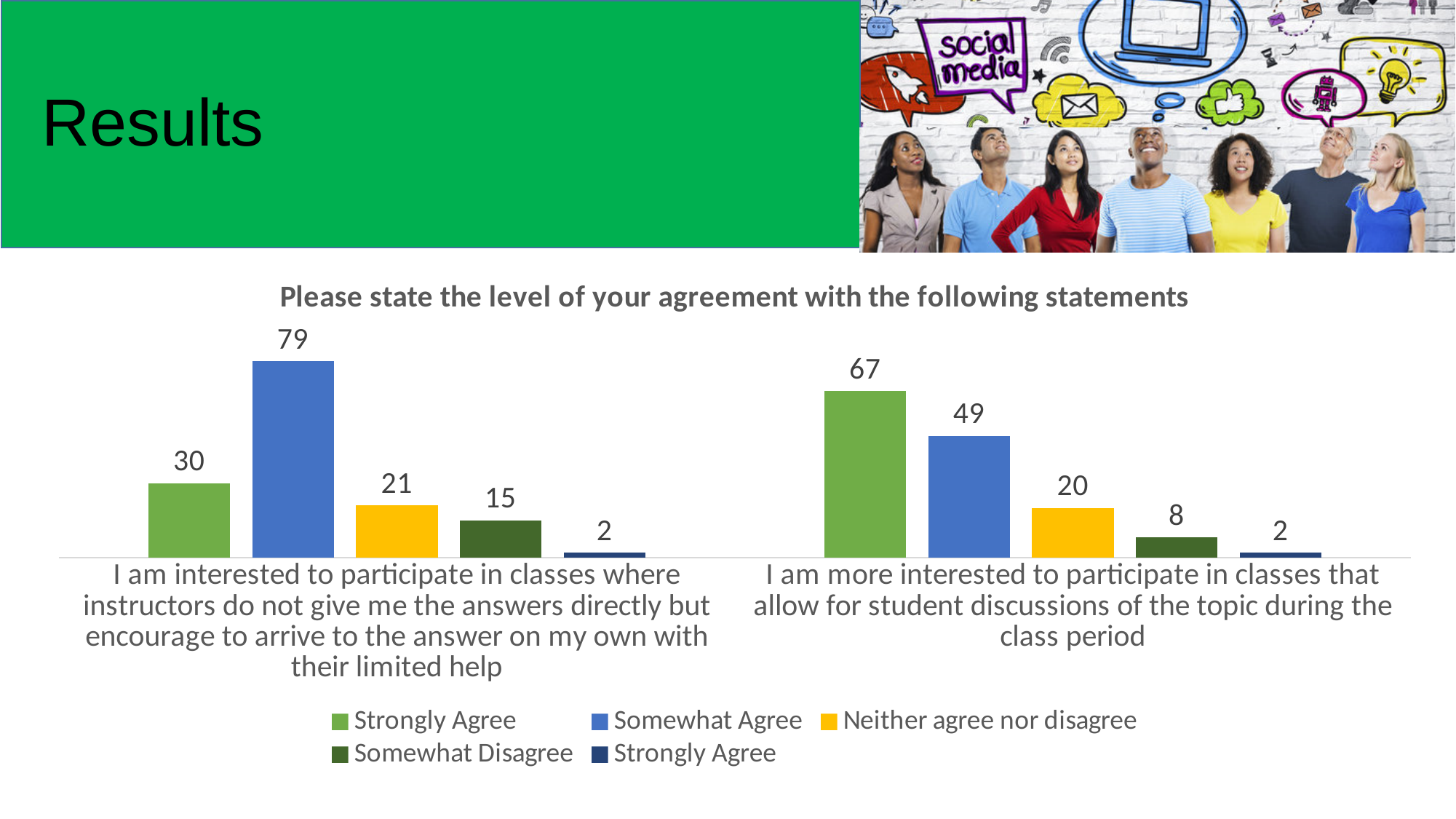
What is the title of the chart? Please state the level of your agreement with the following statements Which response has the highest value for the statement about instructors not giving answers directly? Somewhat Agree How many series does the legend list? 5 Which statement has the larger Somewhat Disagree value? I am interested to participate in classes where instructors do not give me the answers directly... How many statements (categories) are shown on the x axis? 2 What is the difference between the Somewhat Agree values for the two statements? 30 What is the value of the light green (first legend entry) bar for the statement about student discussions during the class period? 67 What is the value for Somewhat Agree for the statement "I am interested to participate in classes where instructors do not give me the answers directly..."? 79 Which response has the lowest value for the statement about student discussions during the class period? Strongly Agree (dark blue, last legend entry) What is the value for Somewhat Disagree for the left-hand statement about instructors not giving answers directly? 15 What is the value for Neither agree nor disagree for the statement "I am more interested to participate in classes that allow for student discussions of the topic during the class period"? 20 What kind of chart is shown on the slide? Bar chart